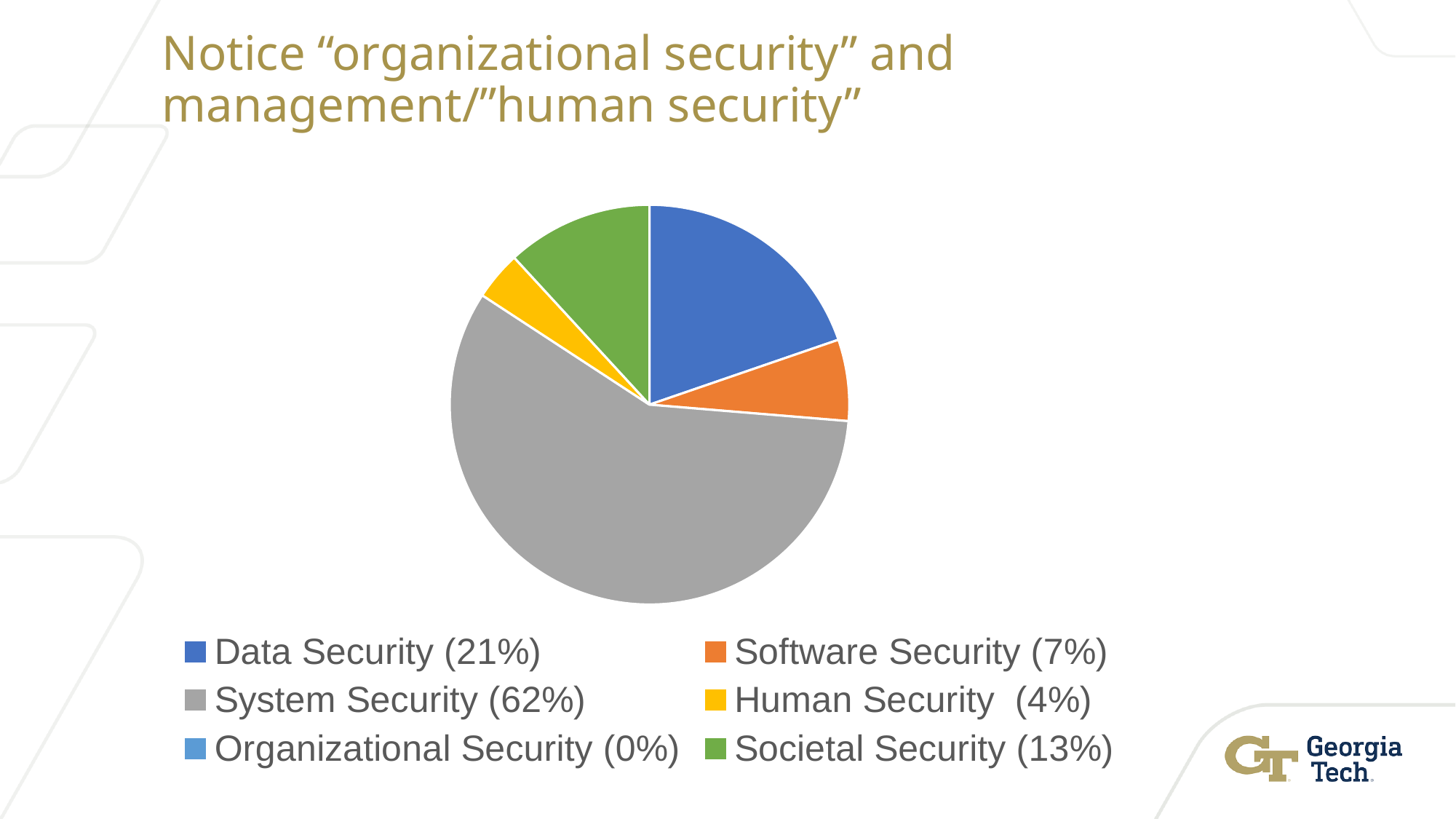
Which is larger, Software Security or Societal Security? Societal Security What kind of chart is shown on the slide? pie chart What is the difference in percentage points between System Security and Data Security? 41 What share of the pie does System Security have? 62% Which category has the largest share of the pie? System Security What percentage is shown for Societal Security in the legend? 13% How many categories does the legend list? 6 What colour is the System Security slice? grey What percentage is shown for Human Security in the legend? 4% Which category has the smallest share of the pie? Organizational Security What share of the pie does Data Security have? 21% What percentage is shown for Organizational Security in the legend? 0%